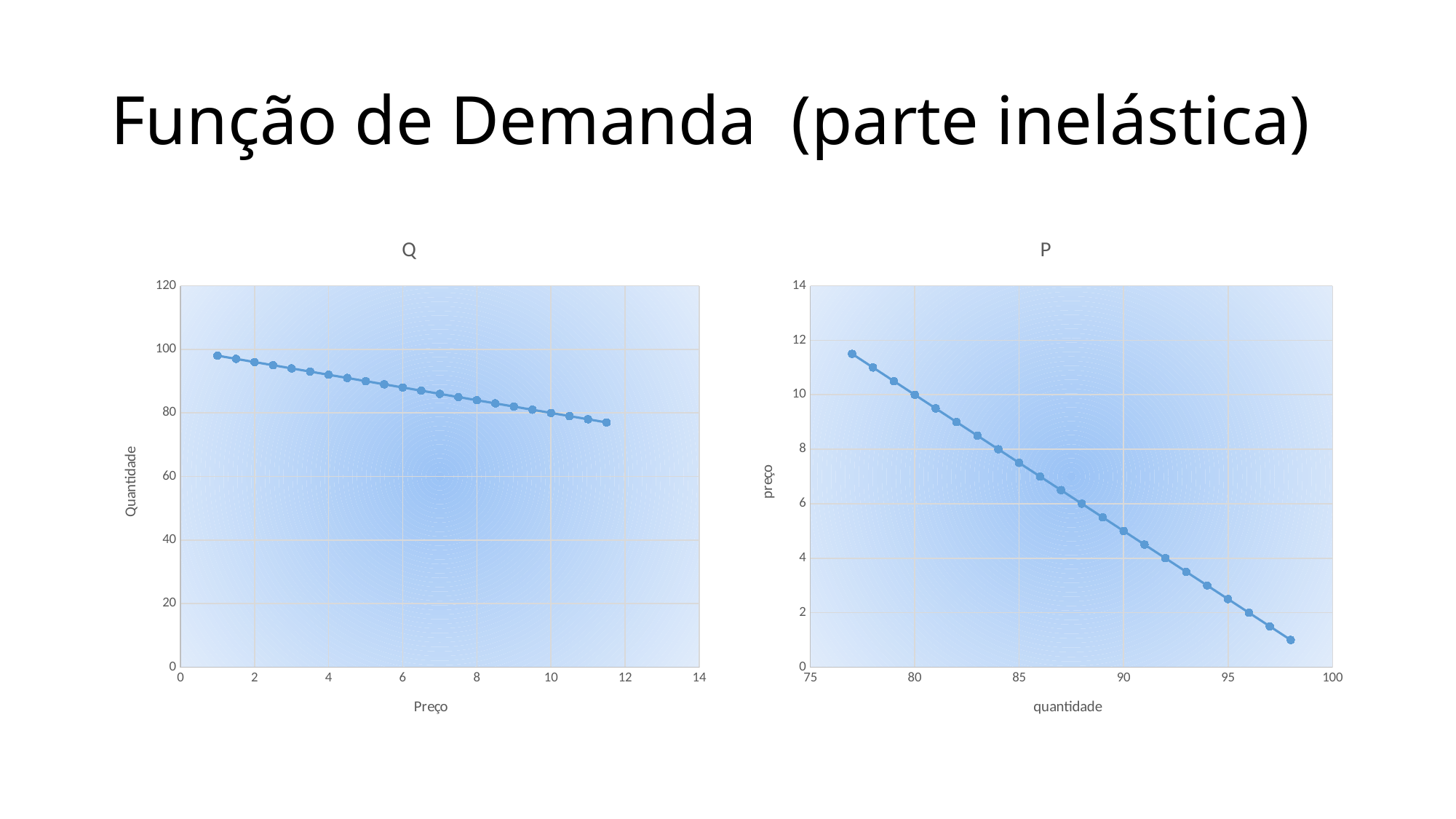
In the right chart titled P, is the preço value at quantidade 95 greater or less than 4? less In the left chart titled Q, do the values rise or fall as Preço increases? fall In the left chart titled Q, is the Quantidade value at Preço 6 greater or less than 60? greater In the left chart titled Q, is the Quantidade value at Preço 2 greater or less than 80? greater What is the label of the x axis of the left chart titled Q? Preço In the left chart titled Q, which is larger: the Quantidade value at Preço 1 or at Preço 11? Preço 1 In the right chart titled P, do the values rise or fall as quantidade increases? fall What kind of chart is the left chart titled Q? line chart What is the label of the y axis of the right chart titled P? preço